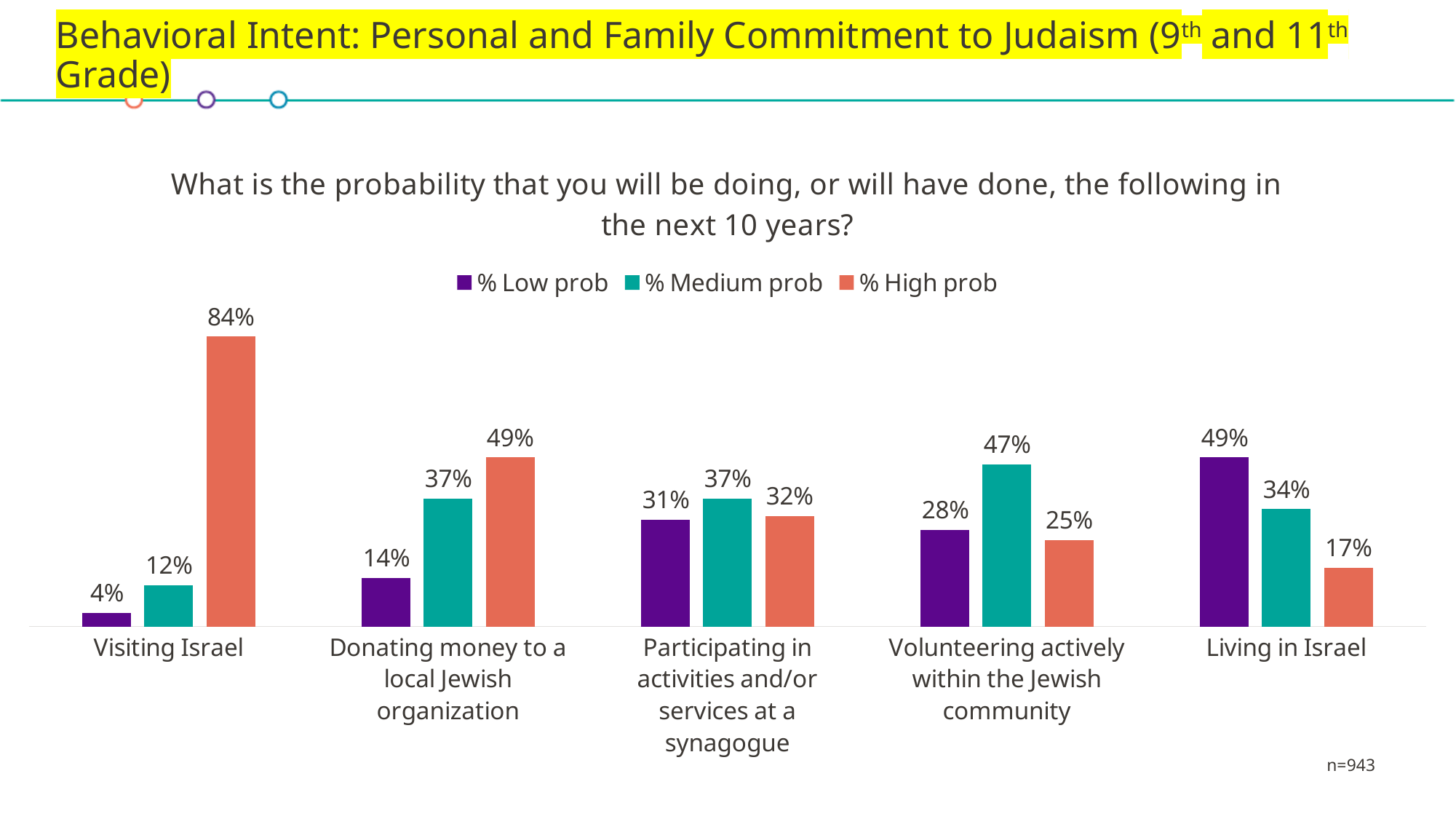
What is the % Low prob value for Living in Israel? 49% How many categories are shown on the x axis? 5 What is the difference between the % High prob and % Low prob values for Visiting Israel? 80% Which category has the lowest % Low prob value? Visiting Israel Which category has the highest % High prob value? Visiting Israel What sample size is noted on the slide? n=943 What kind of chart is shown on the slide? Bar chart What is the % High prob value for Visiting Israel? 84% What is the % Medium prob value for Volunteering actively within the Jewish community? 47% What is the difference between the % Medium prob and % High prob values for Donating money to a local Jewish organization? 12% How many series does the legend list? 3 Which is larger for Living in Israel: % Medium prob or % High prob? % Medium prob